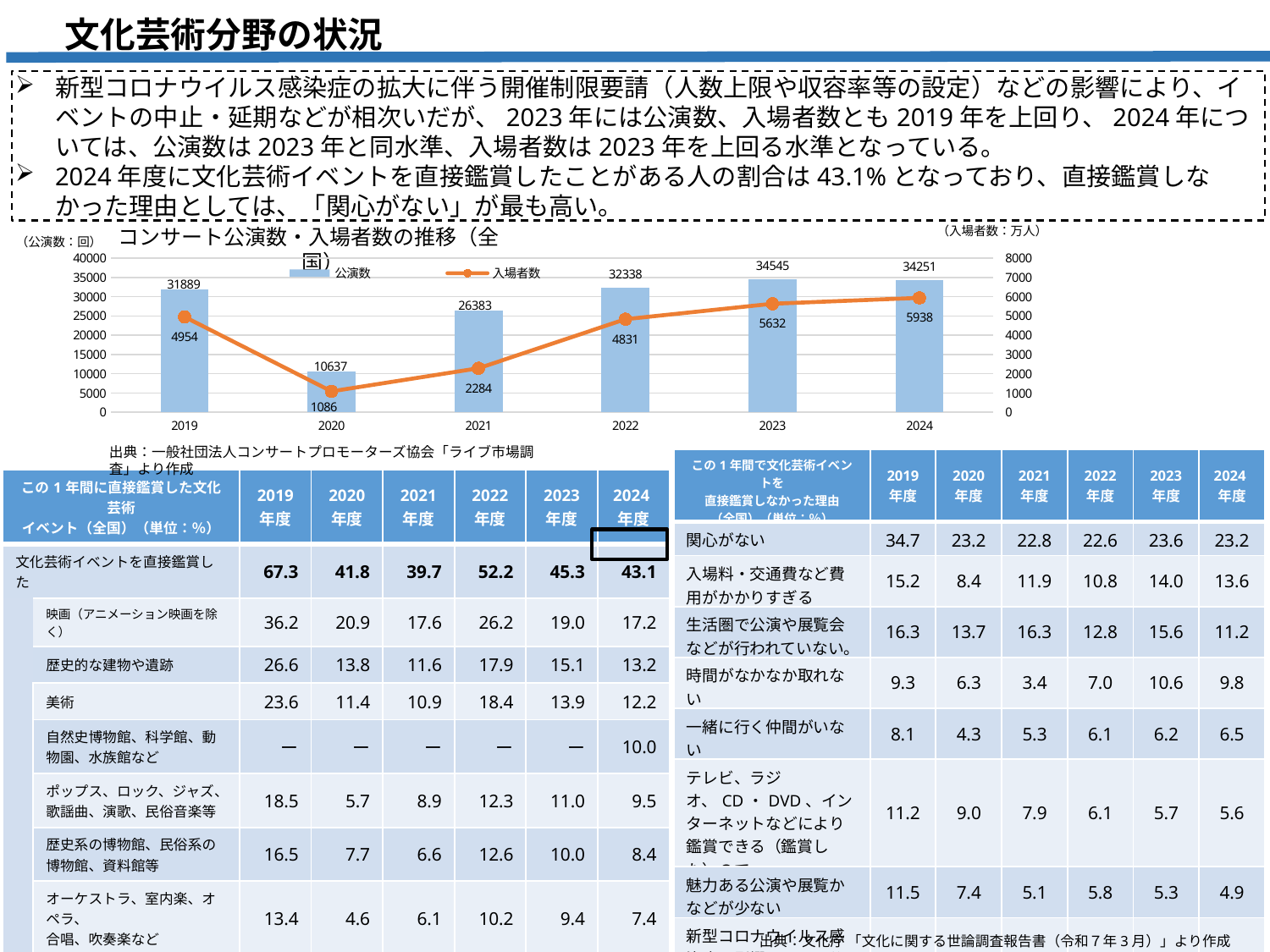
コンサート公演数・入場者数の推移のグラフで、入場者数が最も少ない年はどれですか？ 2020 コンサート公演数・入場者数の推移のグラフで、2020年の入場者数はいくつですか？ 1086 コンサート公演数・入場者数の推移のグラフで、2024年の入場者数はいくつですか？ 5938 コンサート公演数・入場者数の推移のグラフで、2023年と2024年の公演数の差はいくつですか？ 294 コンサート公演数・入場者数の推移のグラフで、2019年と2022年の入場者数はどちらが多いですか？ 2019 コンサート公演数・入場者数の推移のグラフで、2020年から2023年にかけて入場者数は増加していますか、減少していますか？ 増加 コンサート公演数・入場者数の推移のグラフの凡例には、いくつの系列がありますか？ 2 コンサート公演数・入場者数の推移のグラフは、どのような種類のグラフですか？ 棒グラフと折れ線グラフの組み合わせ コンサート公演数・入場者数の推移のグラフで、2021年の公演数は25000より多いですか、少ないですか？ 多い コンサート公演数・入場者数の推移のグラフで、公演数が最も多い年はどれですか？ 2023 コンサート公演数・入場者数の推移のグラフには、何年分のデータが示されていますか？ 6 コンサート公演数・入場者数の推移のグラフで、2019年の公演数はいくつですか？ 31889